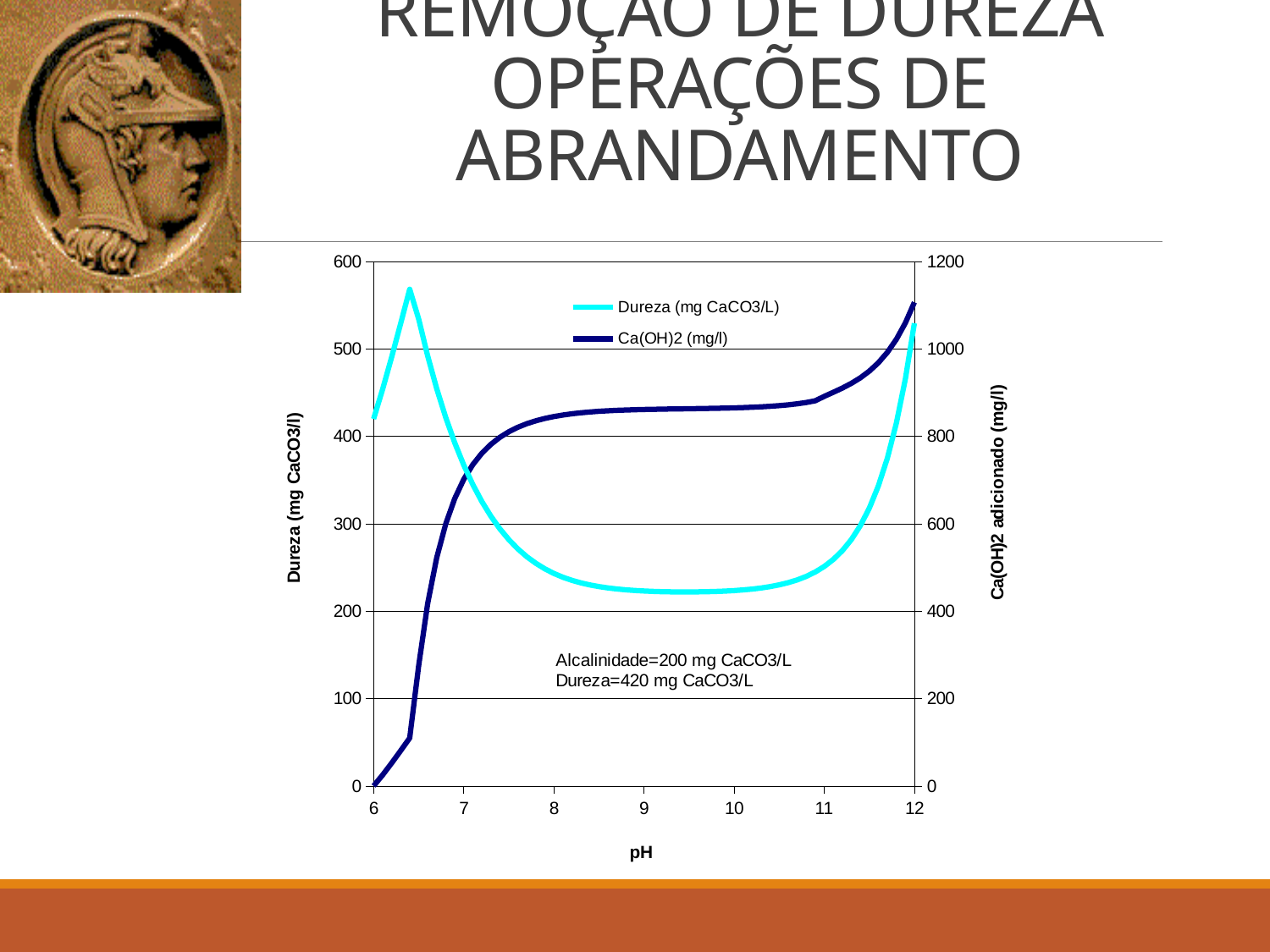
Is the Ca(OH)2 value at pH 9 greater or less than 800 on the right axis? greater Does the Dureza series rise or fall as pH increases from 7 to 9? fall Is the peak Dureza value near pH 6.4 greater or less than 500? greater What are the two series named in the chart legend? Dureza (mg CaCO3/L) and Ca(OH)2 (mg/l) What is the title of the x axis of the chart? pH Is the Dureza value at pH 9 greater or less than 300? less What kind of chart is shown on the slide? line chart Does the Ca(OH)2 series generally rise or fall as pH increases from 6 to 12? rise What is the highest value shown on the right-hand axis (Ca(OH)2 adicionado)? 1200 How many series does the chart legend list? 2